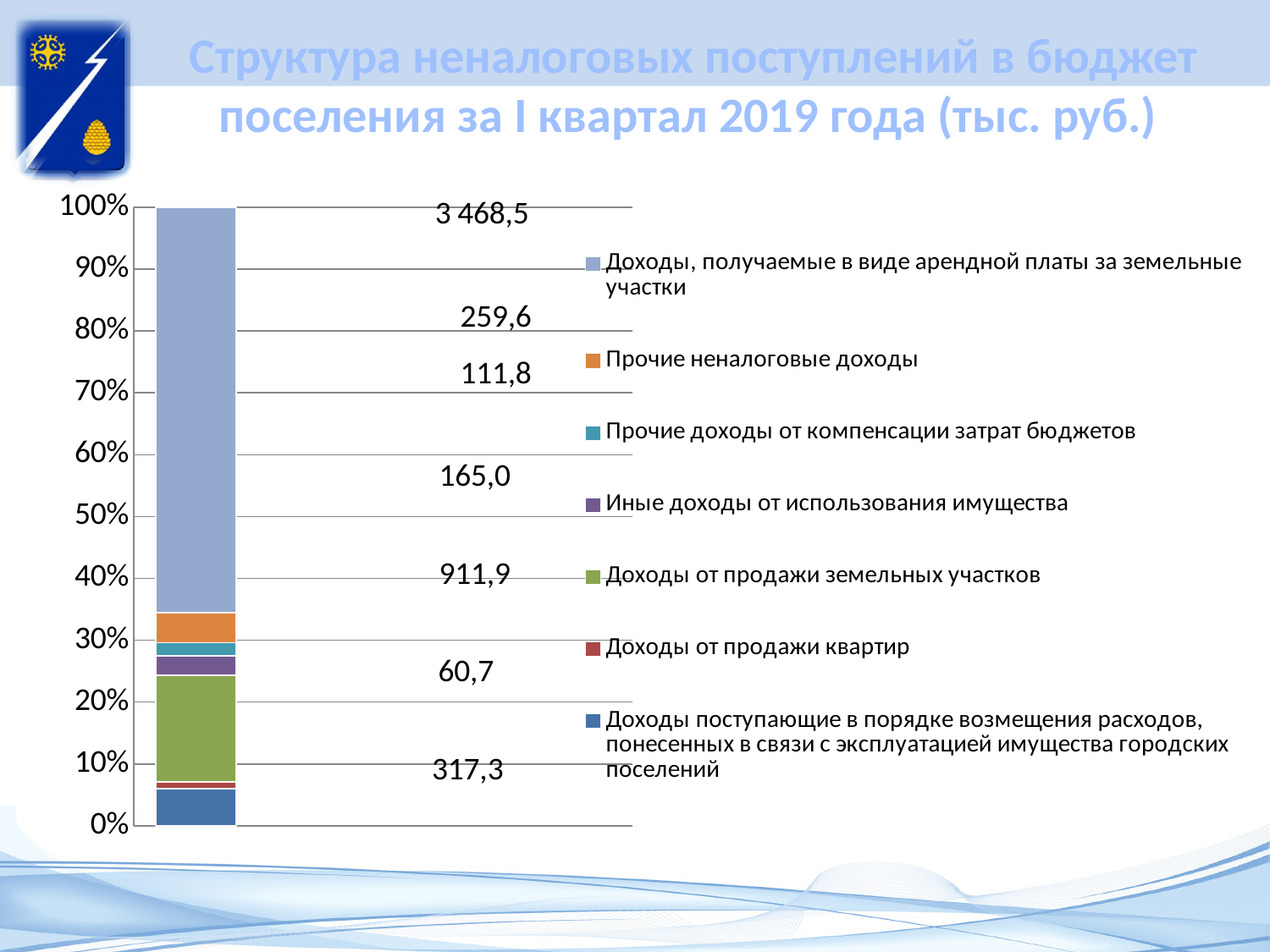
What is the value for «Прочие неналоговые доходы»? 259,6 What kind of chart is shown on the slide? Stacked bar chart What is the value for «Доходы от продажи земельных участков»? 911,9 Which category has the highest value? Доходы, получаемые в виде арендной платы за земельные участки What is the value for «Доходы от продажи квартир»? 60,7 What is the total of all segments in the stacked bar? 5 294,8 Which category has the lowest value? Доходы от продажи квартир What is the difference between «Прочие неналоговые доходы» (259,6) and «Прочие доходы от компенсации затрат бюджетов» (111,8)? 147,8 Which is larger: «Доходы от продажи земельных участков» or «Доходы поступающие в порядке возмещения расходов, понесенных в связи с эксплуатацией имущества городских поселений»? Доходы от продажи земельных участков What is the value for «Доходы, получаемые в виде арендной платы за земельные участки»? 3 468,5 What is the value for «Иные доходы от использования имущества»? 165,0 How many series does the legend list? 7